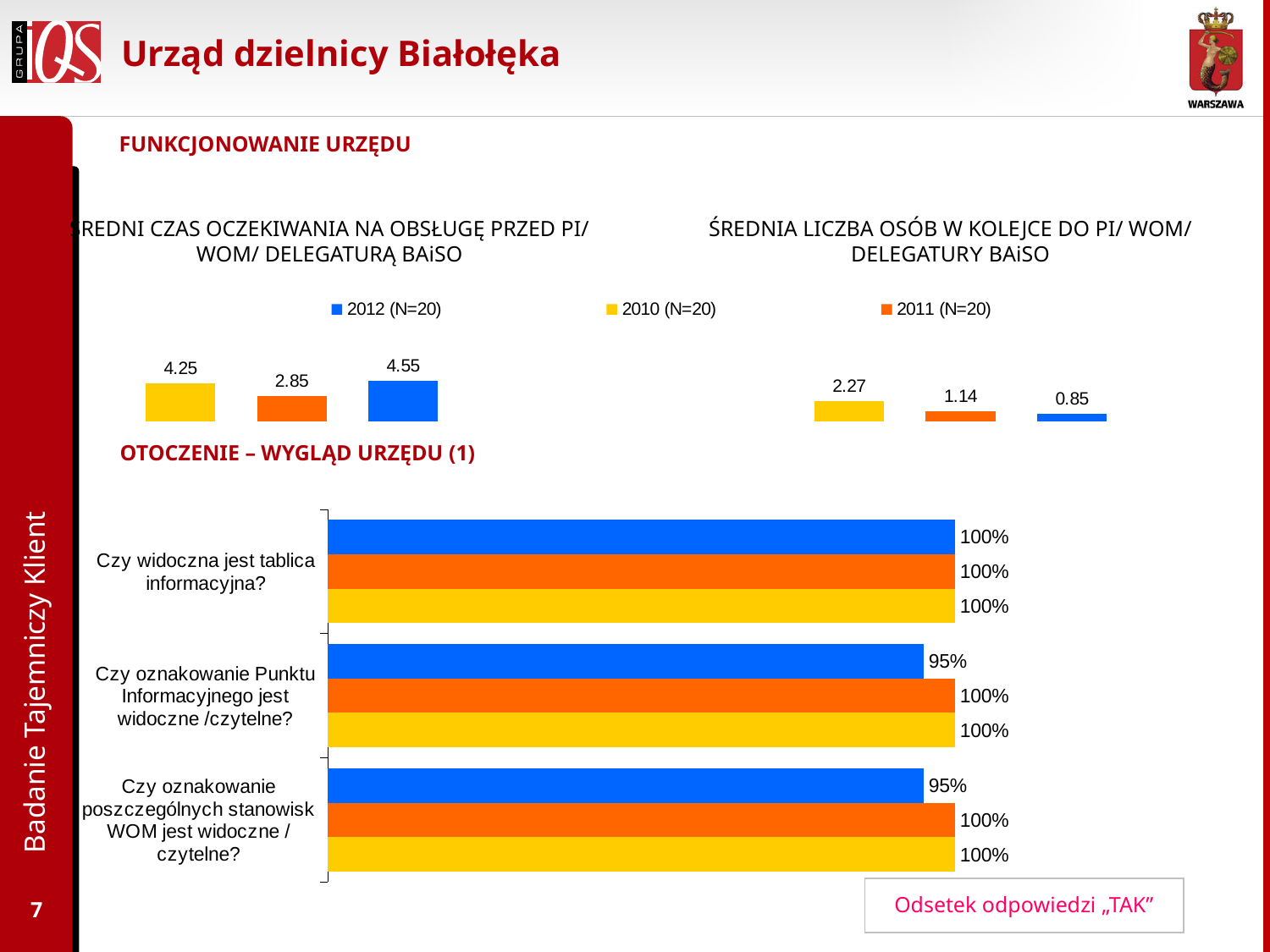
In the bottom chart under "OTOCZENIE – WYGLĄD URZĘDU (1)", what is the 2012 value for "Czy oznakowanie Punktu Informacyjnego jest widoczne /czytelne?"? 95% In the chart titled "ŚREDNI CZAS OCZEKIWANIA NA OBSŁUGĘ PRZED PI/ WOM/ DELEGATURĄ BAiSO", what is the value for 2012? 4.55 In the chart titled "ŚREDNI CZAS OCZEKIWANIA NA OBSŁUGĘ PRZED PI/ WOM/ DELEGATURĄ BAiSO", what is the difference between the 2012 and 2010 values? 0.30 How many question categories are shown in the bottom chart under "OTOCZENIE – WYGLĄD URZĘDU (1)"? 3 In the bottom chart under "OTOCZENIE – WYGLĄD URZĘDU (1)", what is the 2010 value for "Czy widoczna jest tablica informacyjna?"? 100% In the chart titled "ŚREDNI CZAS OCZEKIWANIA NA OBSŁUGĘ PRZED PI/ WOM/ DELEGATURĄ BAiSO", which year has the lowest value? 2011 In the chart titled "ŚREDNIA LICZBA OSÓB W KOLEJCE DO PI/ WOM/ DELEGATURY BAiSO", what is the difference between the 2011 and 2012 values? 0.29 In the chart titled "ŚREDNIA LICZBA OSÓB W KOLEJCE DO PI/ WOM/ DELEGATURY BAiSO", is the value for 2010 larger or smaller than the value for 2011? larger In the chart titled "ŚREDNIA LICZBA OSÓB W KOLEJCE DO PI/ WOM/ DELEGATURY BAiSO", which year has the highest value? 2010 In the chart titled "ŚREDNI CZAS OCZEKIWANIA NA OBSŁUGĘ PRZED PI/ WOM/ DELEGATURĄ BAiSO", what is the value for 2011? 2.85 In the chart titled "ŚREDNIA LICZBA OSÓB W KOLEJCE DO PI/ WOM/ DELEGATURY BAiSO", what is the value for 2010? 2.27 What type of chart is the bottom chart under "OTOCZENIE – WYGLĄD URZĘDU (1)"? bar chart